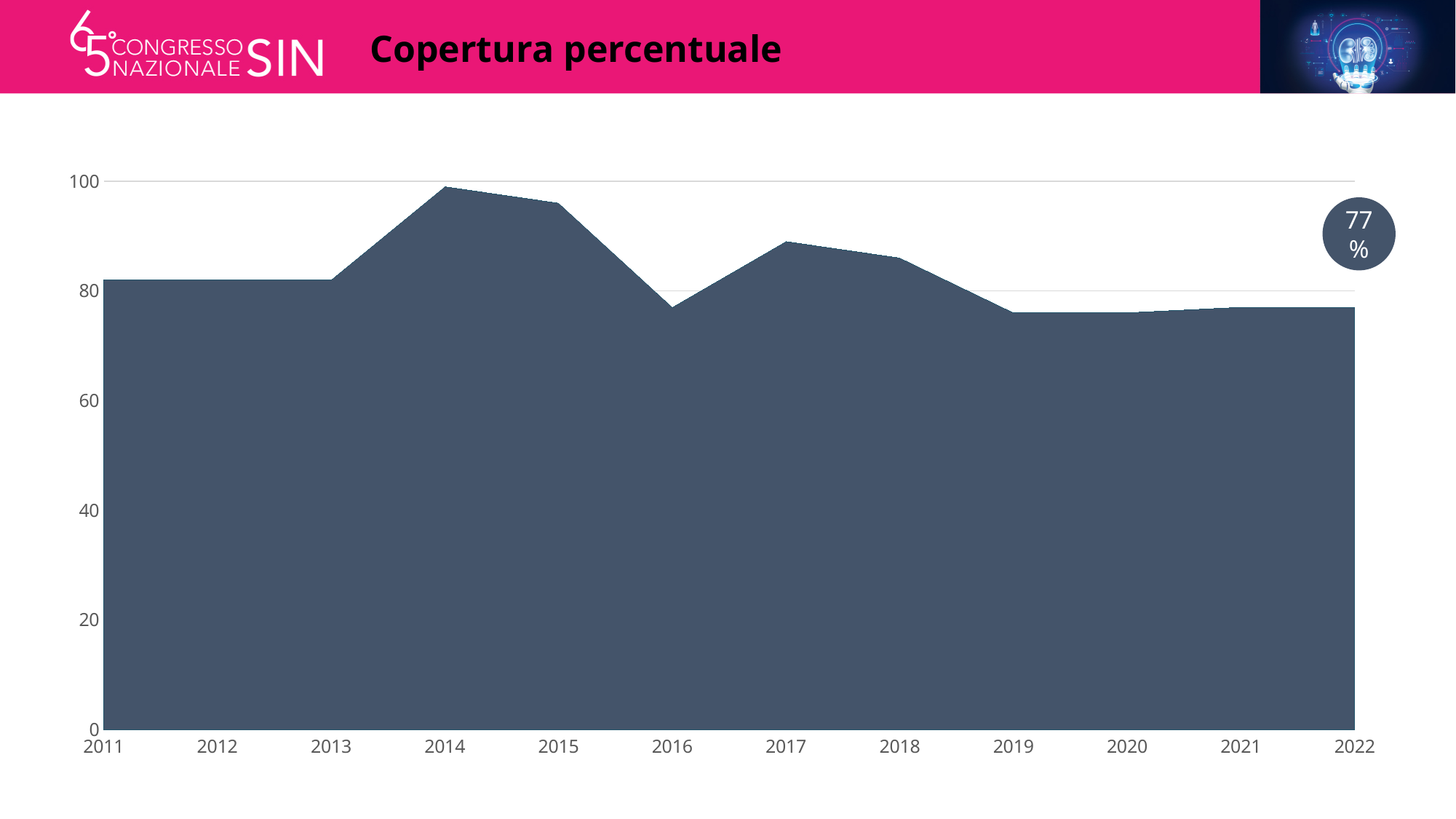
How many years are shown on the x axis of the chart? 12 What kind of chart is shown on the slide? area chart Is the value for 2014 greater or less than 80? greater Is the value for 2019 greater or less than 80? less Is the value for 2017 greater or less than 80? greater Which year has the highest value in the chart? 2014 What is the title of the chart? Copertura percentuale Does the value rise or fall from 2014 to 2016? fall What value is shown in the callout label for 2022? 77% Which year has the larger value, 2014 or 2016? 2014 Which year has the larger value, 2015 or 2018? 2015